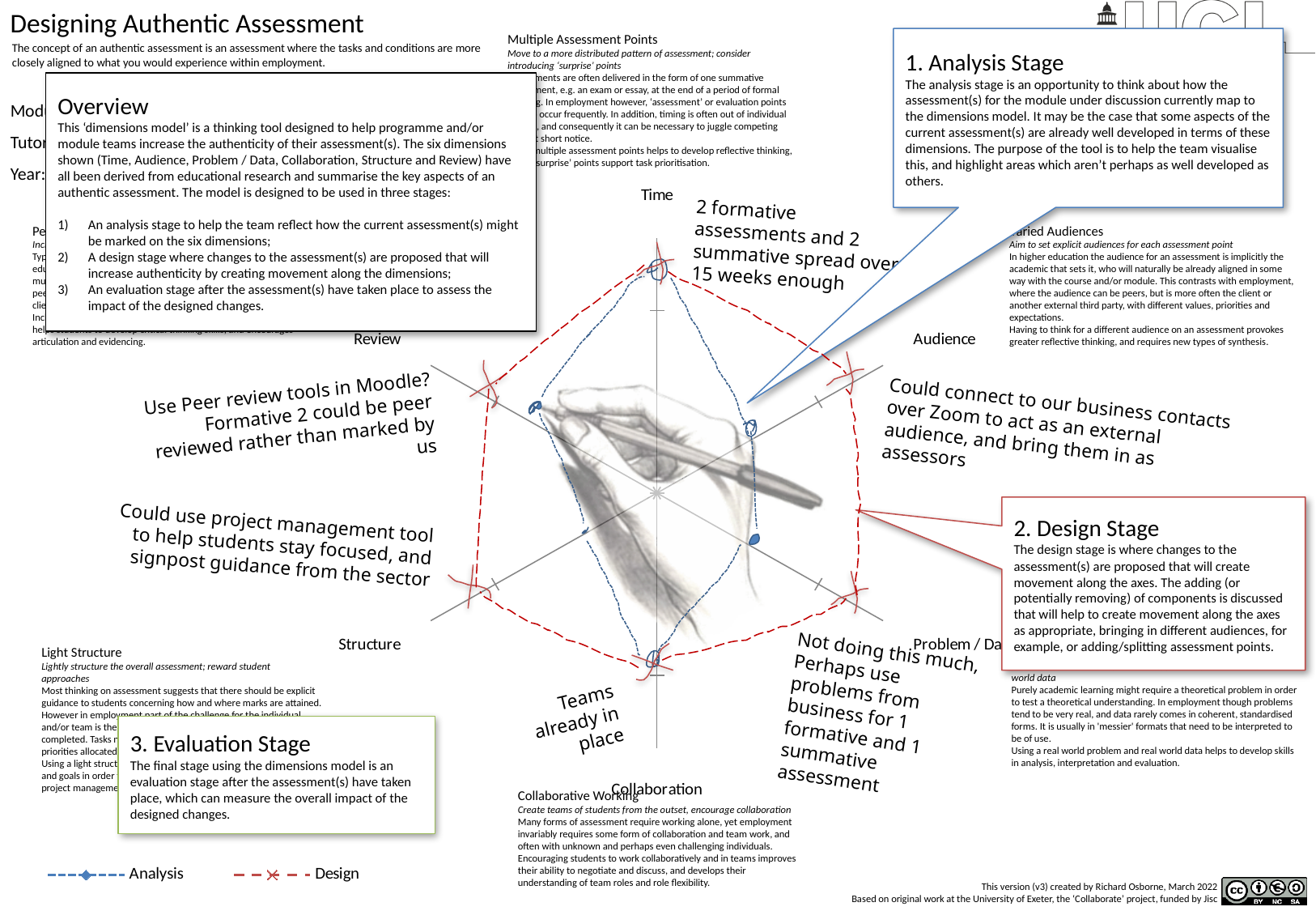
How many axes (dimensions) does the radar chart have? 6 What are the names of the two series in the radar chart's legend? Analysis and Design Which colour is used for the Design series in the radar chart? red On the Problem / Data axis of the radar chart, which series extends further out, Analysis or Design? Design On the Audience axis of the radar chart, which series extends further out, Analysis or Design? Design On the Structure axis of the radar chart, which series extends further out, Analysis or Design? Design How many series does the legend of the radar chart list? 2 What kind of chart is shown on the slide? radar chart Which dimension is labelled at the top of the radar chart? Time